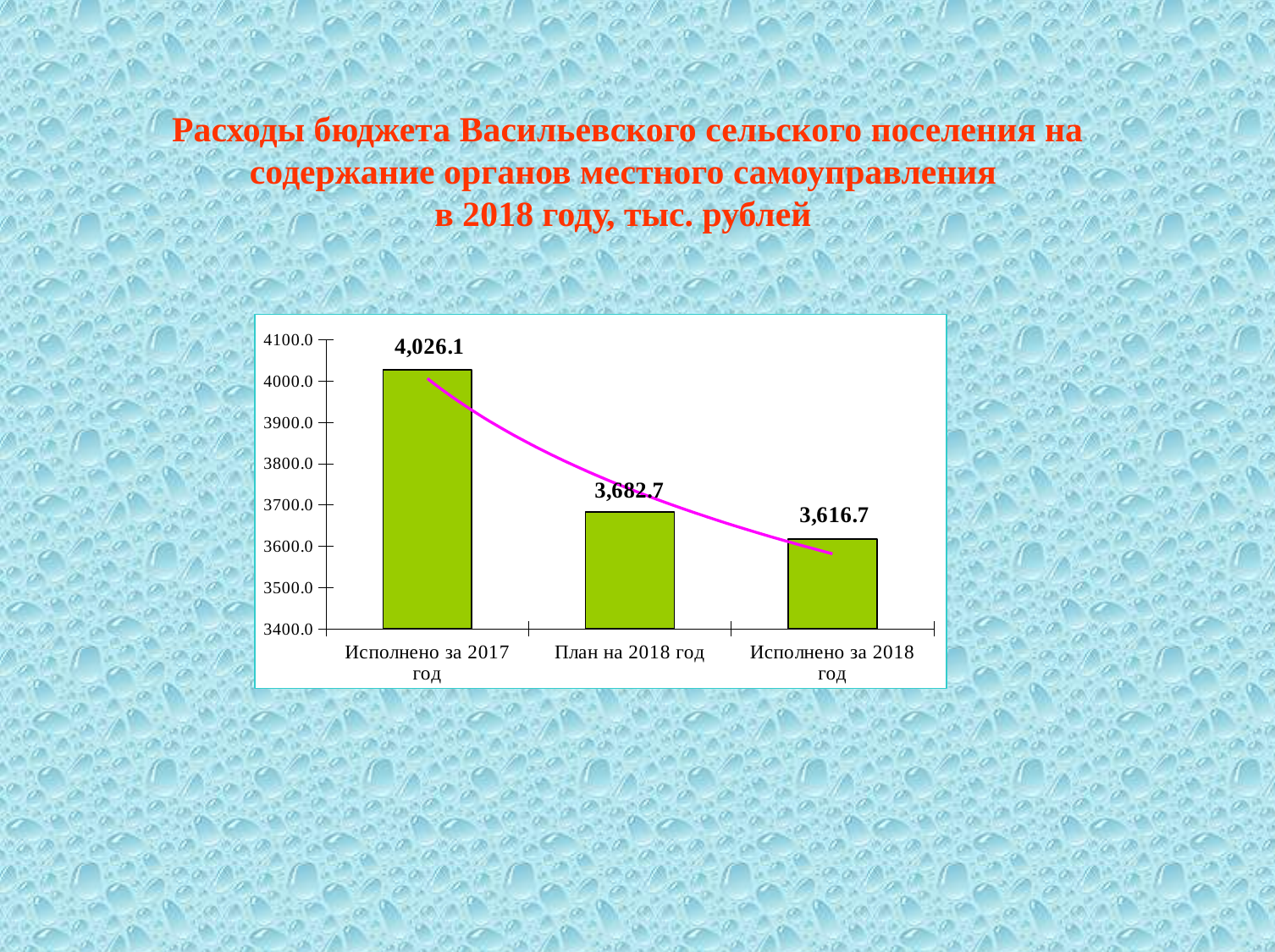
Is the value for "Исполнено за 2017 год" greater or less than 4000.0? greater What is the difference between "План на 2018 год" and "Исполнено за 2018 год"? 66.0 How many bars are shown in the chart? 3 Which is larger, "План на 2018 год" or "Исполнено за 2018 год"? План на 2018 год What kind of chart is shown on the slide? Bar chart What is the difference between "Исполнено за 2017 год" and "Исполнено за 2018 год"? 409.4 What is the value for "План на 2018 год"? 3,682.7 What is the value for "Исполнено за 2018 год"? 3,616.7 Which category has the lowest value? Исполнено за 2018 год Do the values rise or fall from left to right across the categories? Fall What is the value for "Исполнено за 2017 год"? 4,026.1 Which category has the highest value? Исполнено за 2017 год